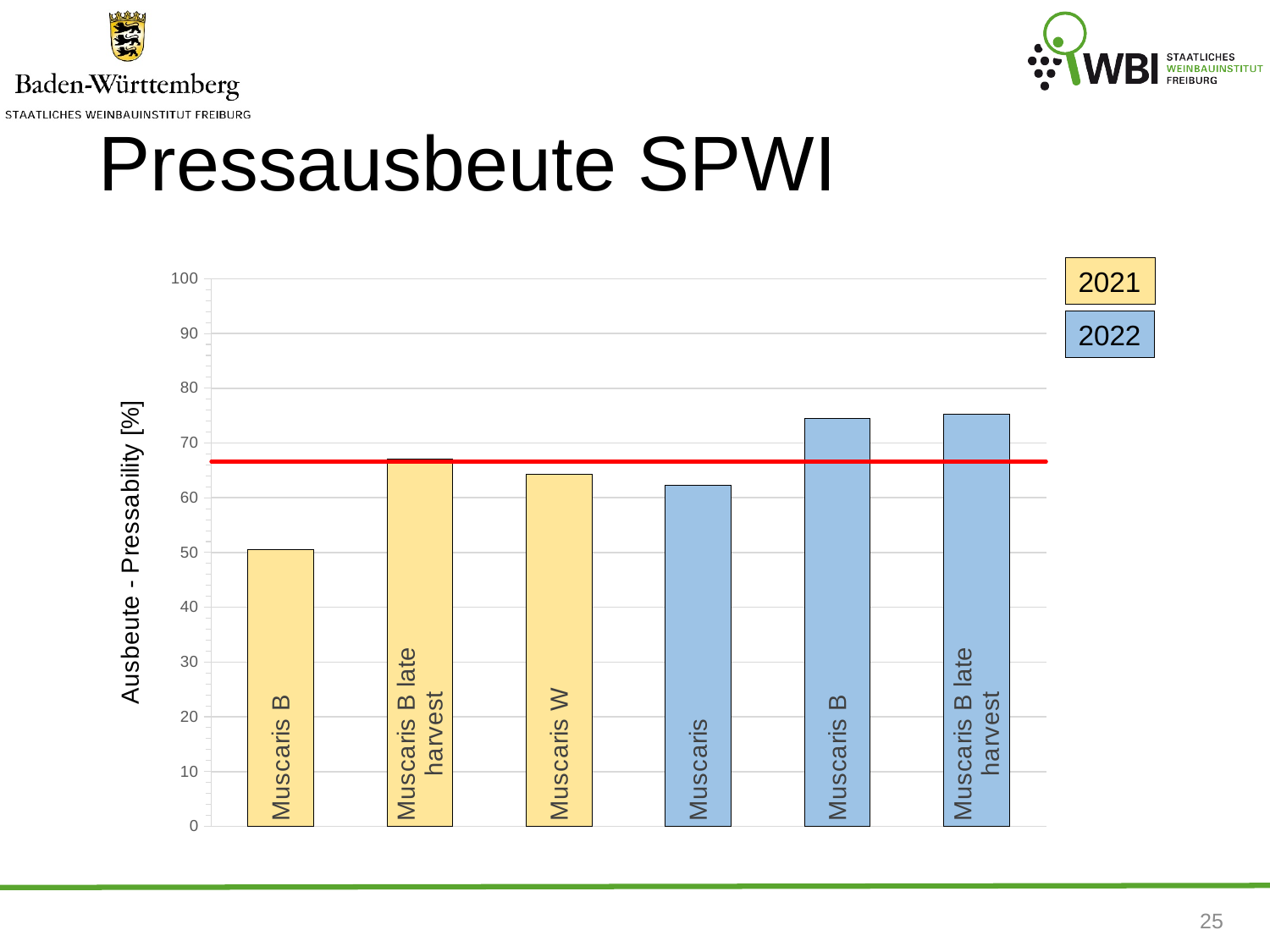
How many bars are plotted in the chart? 6 What kind of chart is shown on the slide? bar chart Is the value for Muscaris W in 2021 greater or less than 60? greater How many series does the legend list? 2 Is the value for Muscaris B late harvest in 2021 greater or less than 60? greater Which bar has the lowest pressability value? Muscaris B (2021) Which is larger: the value for Muscaris B late harvest in 2021 or Muscaris B late harvest in 2022? Muscaris B late harvest in 2022 What is the label of the y axis? Ausbeute - Pressability [%] Is the value for Muscaris B in 2022 greater or less than 70? greater Which is larger: the value for Muscaris B in 2021 or Muscaris B in 2022? Muscaris B in 2022